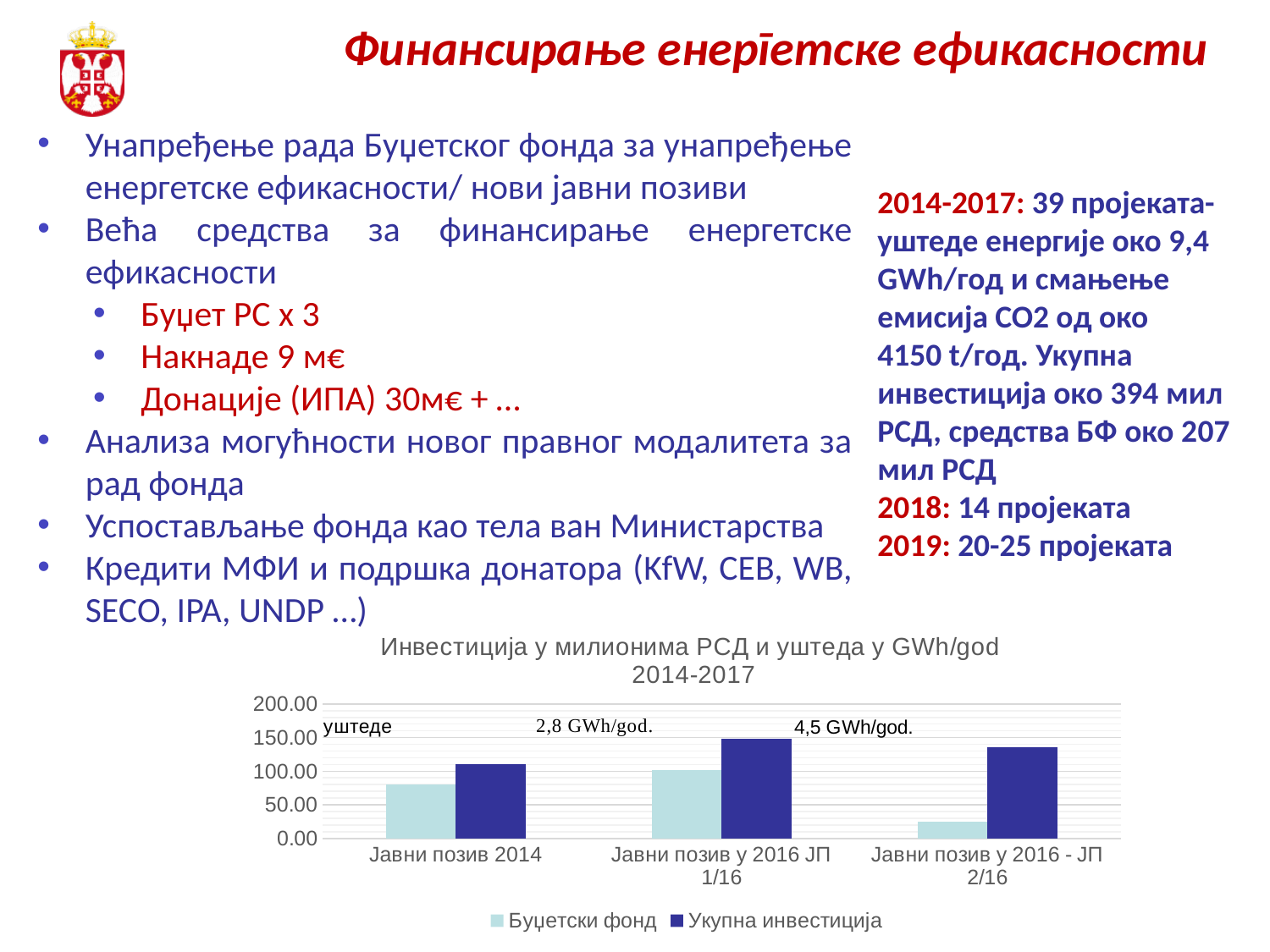
Which category has the lowest value for Укупна инвестиција? Јавни позив 2014 Is the value for Буџетски фонд in Јавни позив у 2016 - ЈП 2/16 greater or less than 50.00? less Is the value for Укупна инвестиција in Јавни позив 2014 greater or less than 100.00? greater Which category has the lowest value for Буџетски фонд? Јавни позив у 2016 - ЈП 2/16 What is the title of the chart? Инвестиција у милионима РСД и уштеда у GWh/god 2014-2017 How many series does the chart legend list? 2 Is the value for Буџетски фонд in Јавни позив 2014 greater or less than 100.00? less Which category has the highest value for Буџетски фонд? Јавни позив у 2016 ЈП 1/16 Which category has the highest value for Укупна инвестиција? Јавни позив у 2016 ЈП 1/16 How many categories are shown on the x axis of the chart? 3 What kind of chart is shown on the slide? bar chart For Јавни позив у 2016 - ЈП 2/16, which is larger: Буџетски фонд or Укупна инвестиција? Укупна инвестиција